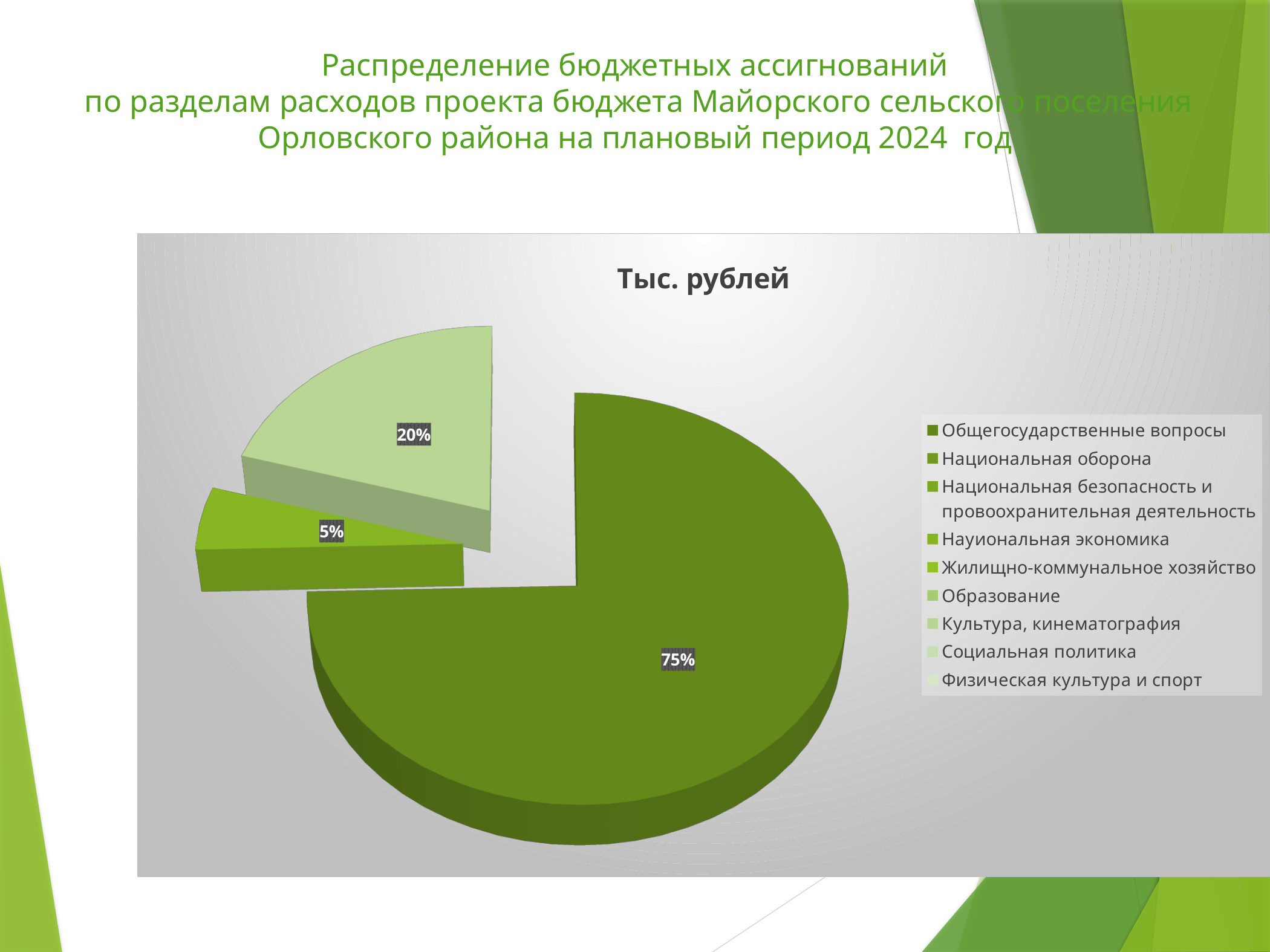
How many entries does the chart legend list? 9 What do the three labelled slices (75%, 20%, 5%) add up to? 100% How many slices of the pie have a percentage label? 3 What is the difference between the 20% slice and the 5% slice? 15 percentage points What is the title of the chart? Тыс. рублей Which legend entry is listed first? Общегосударственные вопросы What is the share of the smallest labelled slice of the pie? 5% Which is larger, the pale green slice labelled 20% or the bright green slice labelled 5%? the 20% slice Is the share of the largest slice greater or less than 50%? greater What is the share of the largest slice of the pie? 75% What is the difference between the largest slice (75%) and the 20% slice? 55 percentage points What kind of chart is shown on the slide? pie chart